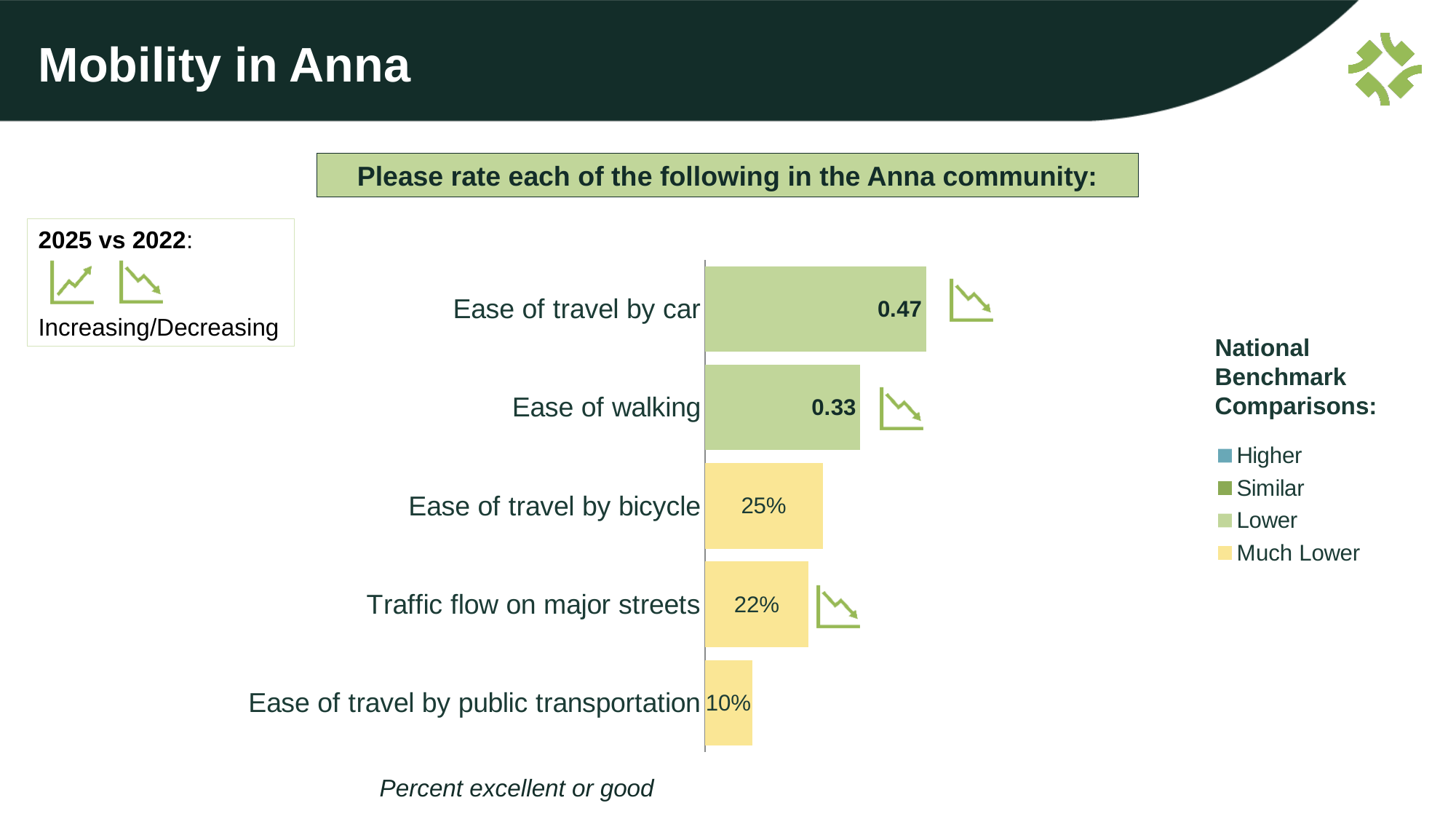
What value is shown for Ease of travel by car? 0.47 What is the difference between the values for Ease of travel by bicycle and Ease of travel by public transportation? 15% What percentage is shown for Ease of travel by bicycle? 25% How many categories are plotted in the chart? 5 Which is larger, the value for Traffic flow on major streets or the value for Ease of travel by public transportation? Traffic flow on major streets Which category has the longest bar? Ease of travel by car What value is shown for Ease of walking? 0.33 What percentage is shown for Ease of travel by public transportation? 10% Which category has the shortest bar? Ease of travel by public transportation What percentage is shown for Traffic flow on major streets? 22% How many entries does the National Benchmark Comparisons legend list? 4 What kind of chart is shown on the slide? Bar chart